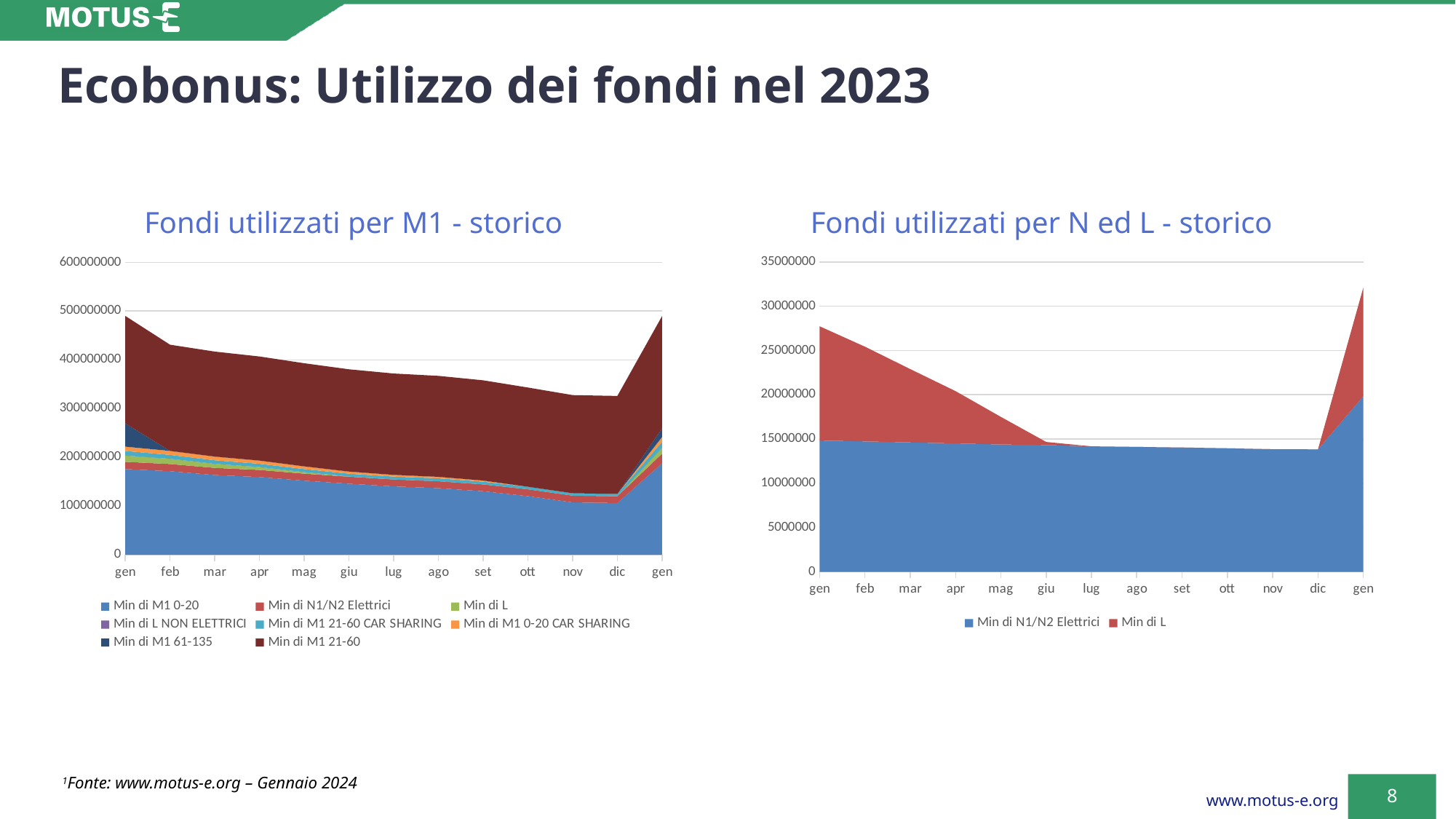
In "Fondi utilizzati per N ed L - storico", does the Min di L area rise or fall from gen to giu? fall In "Fondi utilizzati per M1 - storico", does the total stacked value rise or fall from the first gen to dic? fall How many series does the legend of "Fondi utilizzati per M1 - storico" list? 8 In "Fondi utilizzati per N ed L - storico", is the total stacked value at dic greater or less than 20000000? less Which series is shown in red in "Fondi utilizzati per N ed L - storico"? Min di L What kind of chart is "Fondi utilizzati per M1 - storico"? stacked area chart In "Fondi utilizzati per M1 - storico", is the total stacked value at dic greater or less than 400000000? less How many points are plotted along the x axis of "Fondi utilizzati per N ed L - storico"? 13 How many series does the legend of "Fondi utilizzati per N ed L - storico" list? 2 In "Fondi utilizzati per M1 - storico", is the total stacked value at the first gen greater or less than 400000000? greater